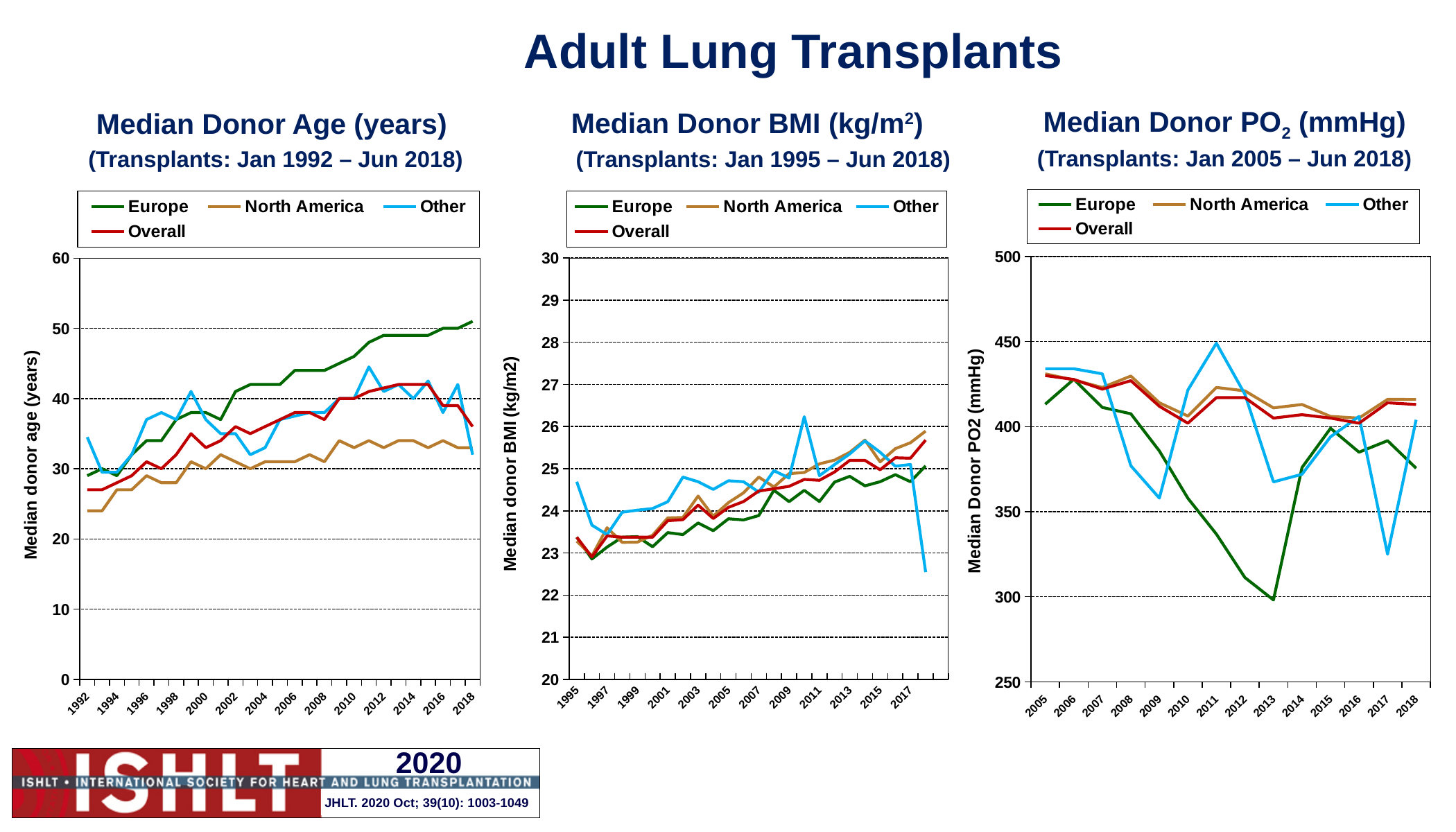
In the Median Donor Age (years) chart, is the value for Europe in 2018 greater or less than 45? greater In the Median Donor BMI (kg/m2) chart, which series has the highest value in 2010? Other In the Median Donor PO2 (mmHg) chart, which series has the lowest value in 2013? Europe In the Median Donor BMI (kg/m2) chart, does the North America series generally rise or fall from 1995 to 2018? rise In the Median Donor Age (years) chart, which series has the highest value in 2018? Europe In the Median Donor Age (years) chart, does the Europe series generally rise or fall from 1992 to 2018? rise How many years are plotted on the x axis of the Median Donor PO2 (mmHg) chart? 14 What kind of chart is the Median Donor Age (years) chart? line chart How many series does the legend of the Median Donor BMI (kg/m2) chart list? 4 In the Median Donor BMI (kg/m2) chart, is the value for Other in 2018 greater or less than 23? less In the Median Donor PO2 (mmHg) chart, is the value for Europe in 2013 greater or less than 350? less In the Median Donor Age (years) chart, which series has the lowest value in 2010? North America